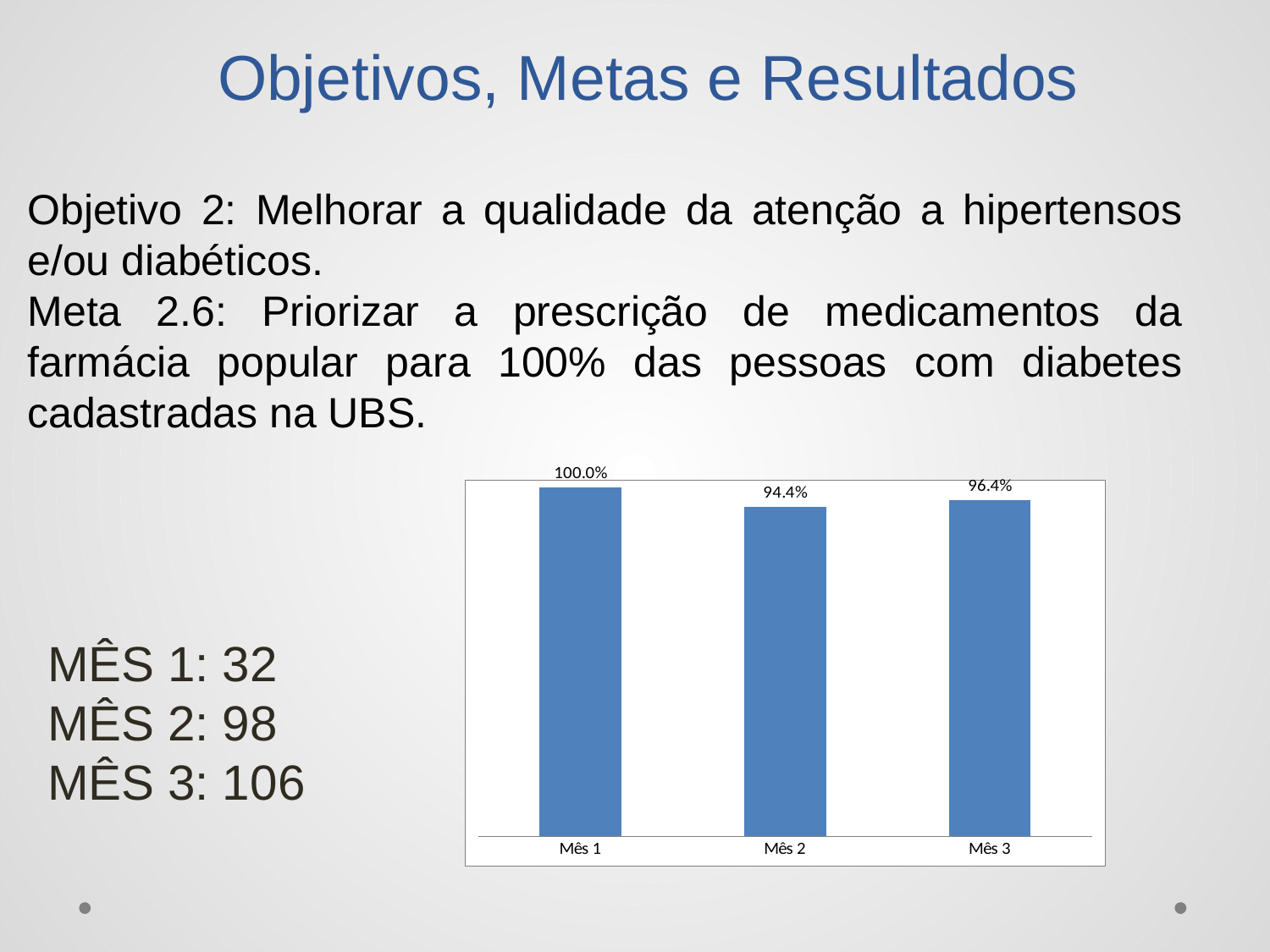
What is the difference between the values for Mês 1 and Mês 2? 5.6% What is the value for Mês 1? 100.0% Which is larger, the value for Mês 2 or the value for Mês 3? Mês 3 What is the value for Mês 3? 96.4% Does the value rise or fall from Mês 1 to Mês 2? Fall Which month has the lowest value? Mês 2 What colour are the bars in the chart? Blue What is the difference between the values for Mês 3 and Mês 2? 2.0% Which month has the highest value? Mês 1 What is the value for Mês 2? 94.4% What kind of chart is shown on the slide? Bar chart How many bars are shown in the chart? 3